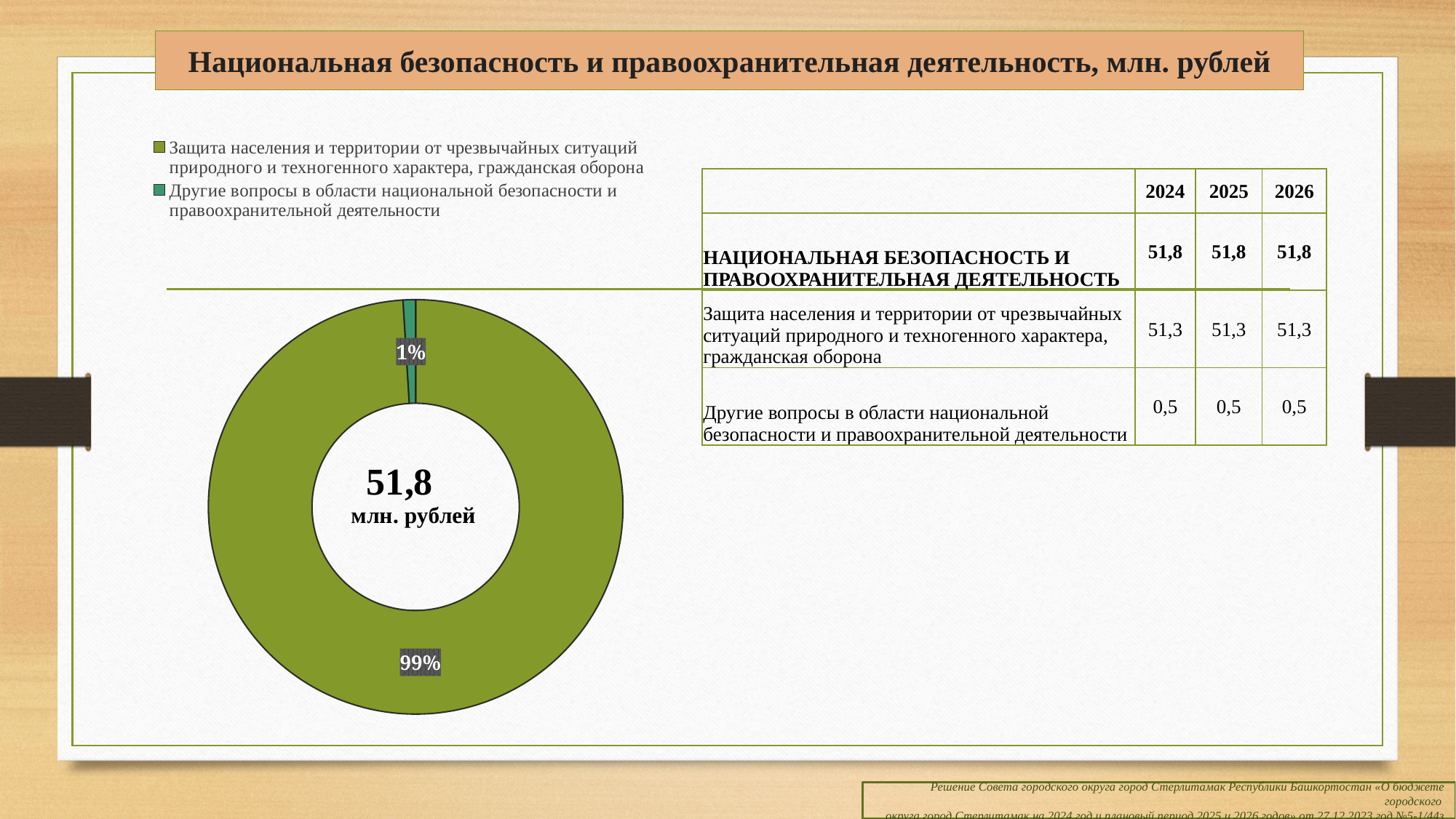
What share of the doughnut chart does "Другие вопросы в области национальной безопасности и правоохранительной деятельности" take? 1% Which slice is larger: "Защита населения и территории..." or "Другие вопросы в области национальной безопасности..."? Защита населения и территории от чрезвычайных ситуаций природного и техногенного характера, гражданская оборона How many entries does the chart legend list? 2 Which category has the largest slice in the doughnut chart? Защита населения и территории от чрезвычайных ситуаций природного и техногенного характера, гражданская оборона What total value is printed in the centre of the doughnut chart? 51,8 млн. рублей How many slices does the doughnut chart have? 2 What is the title of the slide containing the doughnut chart? Национальная безопасность и правоохранительная деятельность, млн. рублей What share of the doughnut chart does "Защита населения и территории от чрезвычайных ситуаций природного и техногенного характера, гражданская оборона" take? 99% What kind of chart is shown on the slide? Doughnut (pie) chart Which category has the smallest slice in the doughnut chart? Другие вопросы в области национальной безопасности и правоохранительной деятельности What is the difference in percentage points between the two slices of the doughnut chart? 98 percentage points